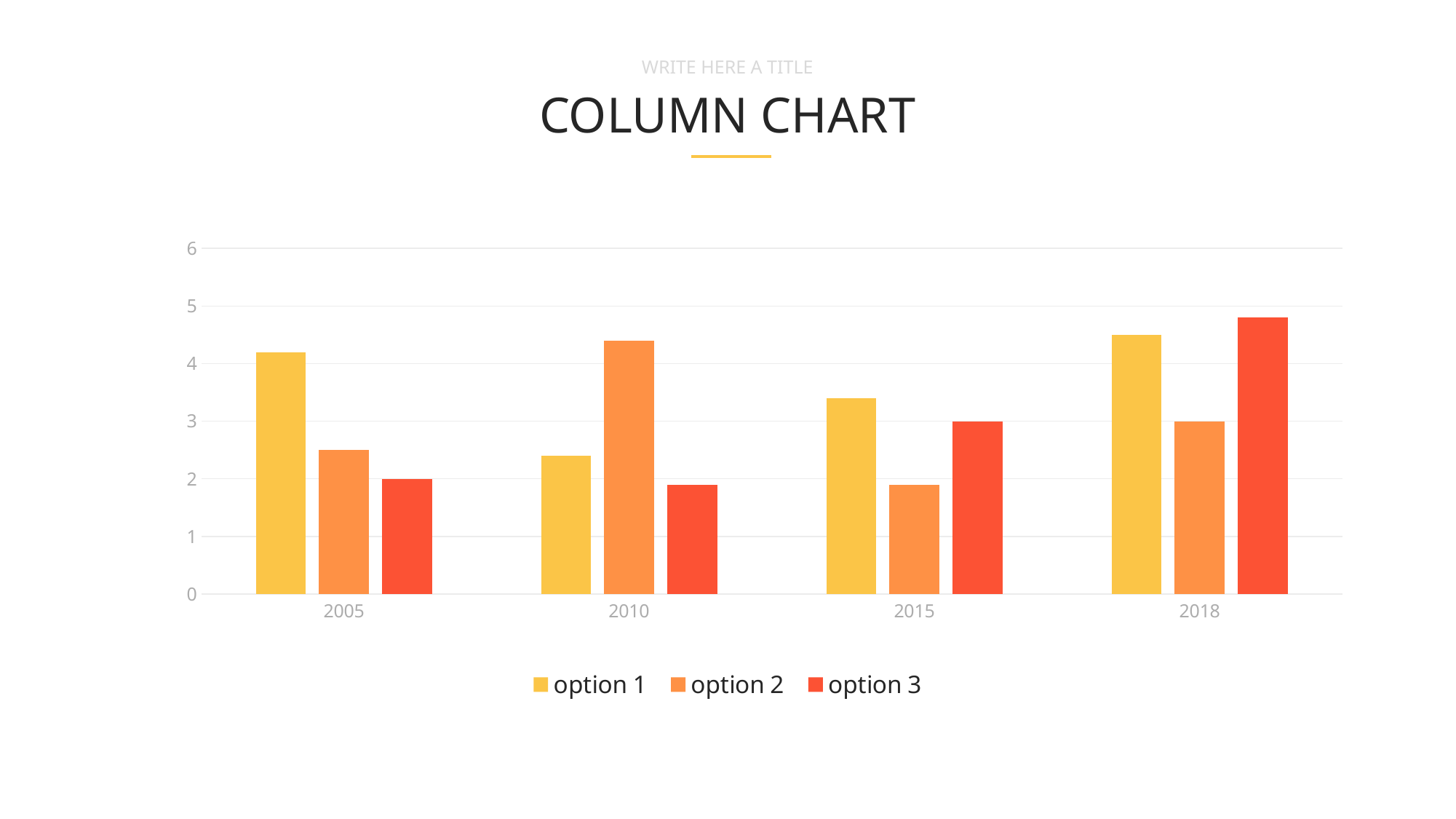
Is the value for option 1 in 2005 greater or less than 4? greater What kind of chart is shown on the slide? bar chart Is the value for option 3 in 2018 greater or less than 5? less Is the value for option 1 in 2010 greater or less than 3? less How many year categories are shown on the x axis? 4 Does the value for option 3 rise or fall from 2010 to 2018? rise In 2005, which is larger: option 1 or option 2? option 1 Which series has the tallest bar in 2018? option 3 What is the title of the chart on the slide? COLUMN CHART How many series does the legend list? 3 Which series has the shortest bar in 2005? option 3 Which series has the tallest bar in 2010? option 2